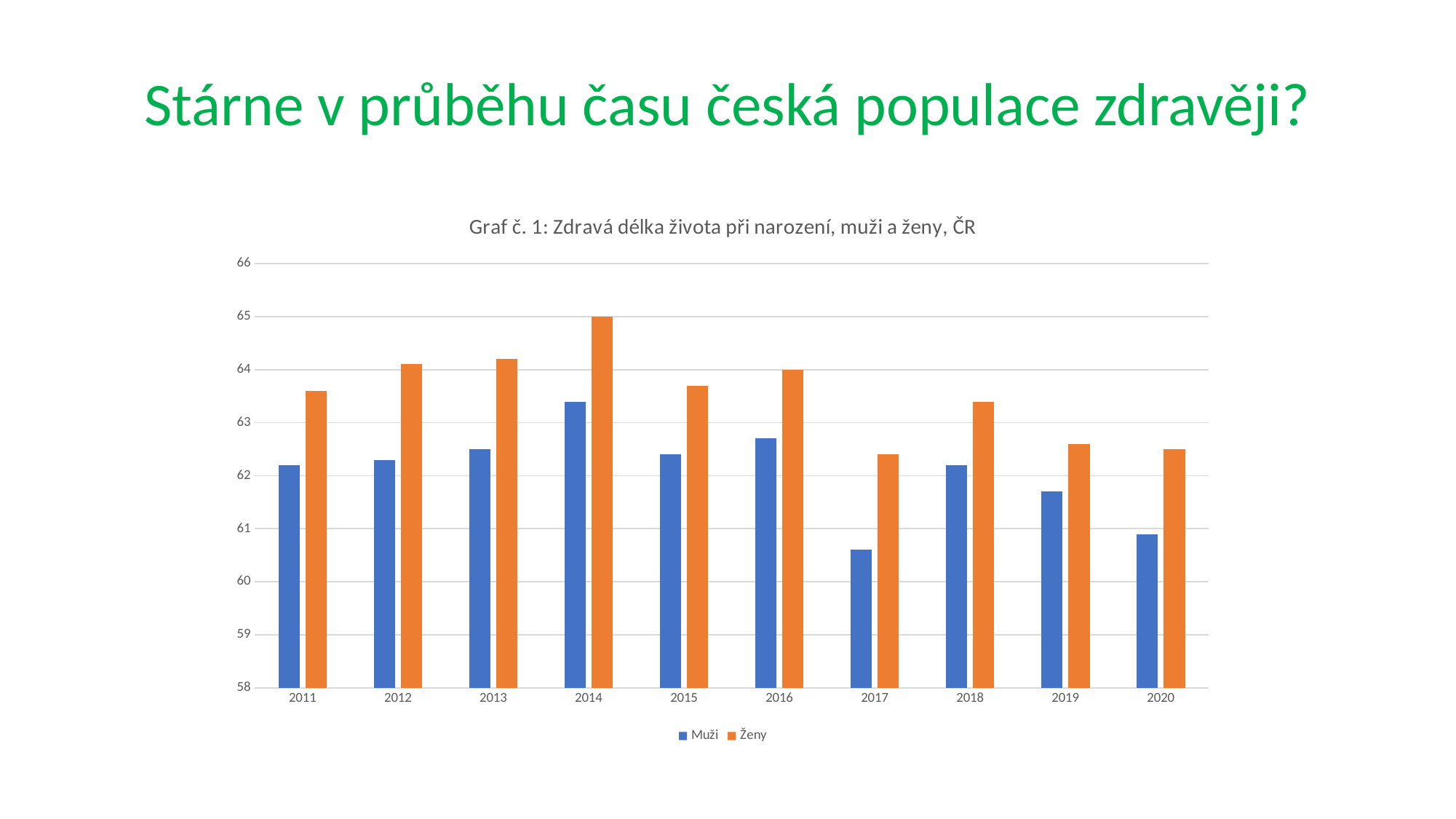
Which is larger in 2019, the value for Muži or the value for Ženy? Ženy In which year is the value for Muži lowest? 2017 Is the value for Muži in 2020 greater or less than 62? less Which colour represents the Ženy series? orange What is the title of the chart? Graf č. 1: Zdravá délka života při narození, muži a ženy, ČR What kind of chart is shown on the slide? bar chart In which year is the value for Ženy highest? 2014 Is the value for Ženy in 2013 greater or less than 64? greater How many series does the legend list? 2 In which year is the value for Muži highest? 2014 Is the value for Muži in 2017 greater or less than 61? less How many years are shown on the x axis? 10